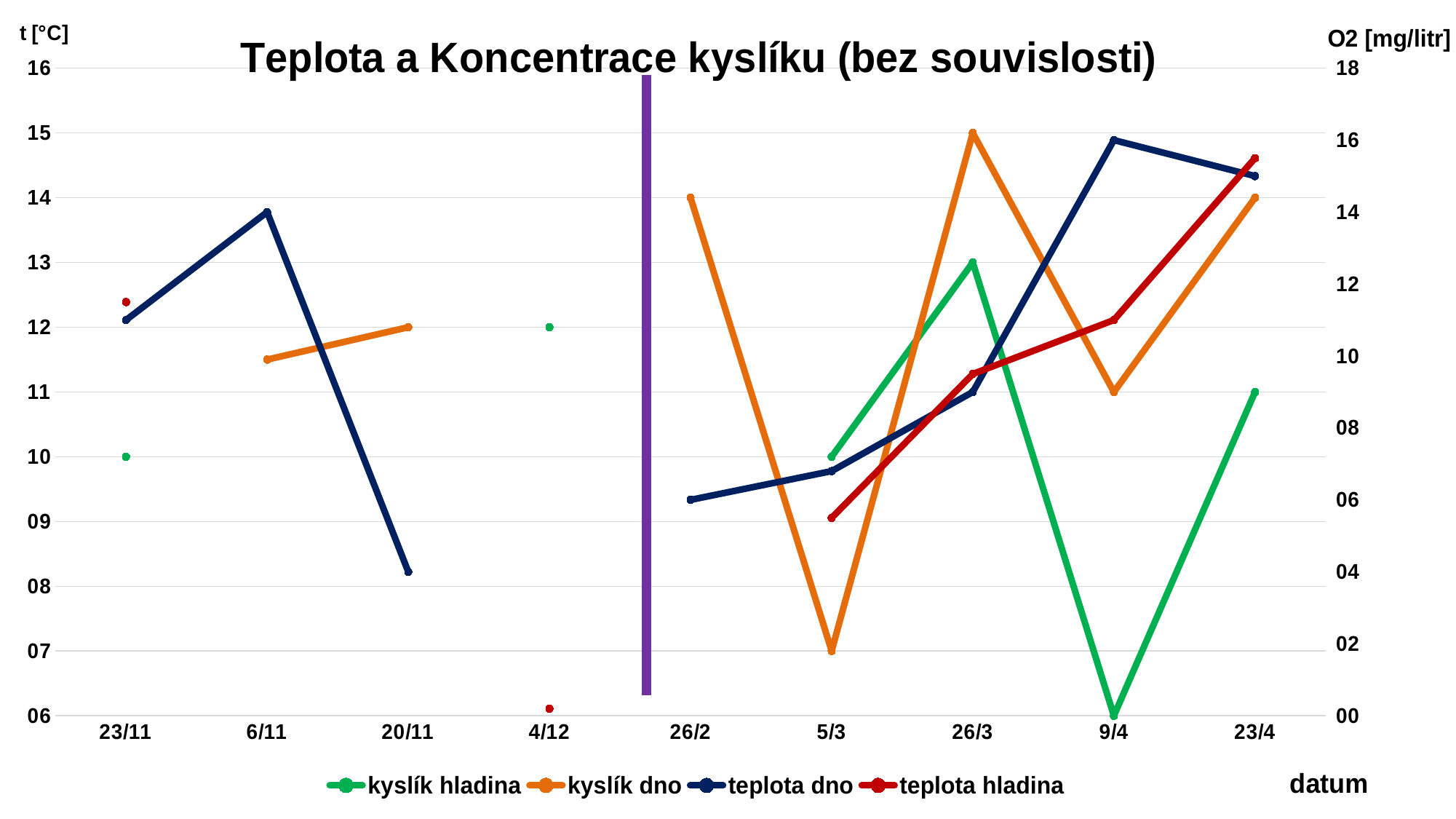
How many dates are shown on the x axis? 9 Is the value for teplota dno at 20/11 greater or less than 9? less What is the title of the chart? Teplota a Koncentrace kyslíku (bez souvislosti) How many series does the legend list? 4 On which date does teplota dno reach its highest value? 9/4 Is the value for teplota dno at 9/4 greater or less than 14? greater What kind of chart is shown on the slide? line chart What is the label of the right-hand vertical axis? O2 [mg/litr] On which date does kyslík hladina reach its lowest value? 9/4 Is the value for kyslík hladina at 26/3 greater or less than 10? greater At 9/4, which is higher: teplota dno or teplota hladina? teplota dno